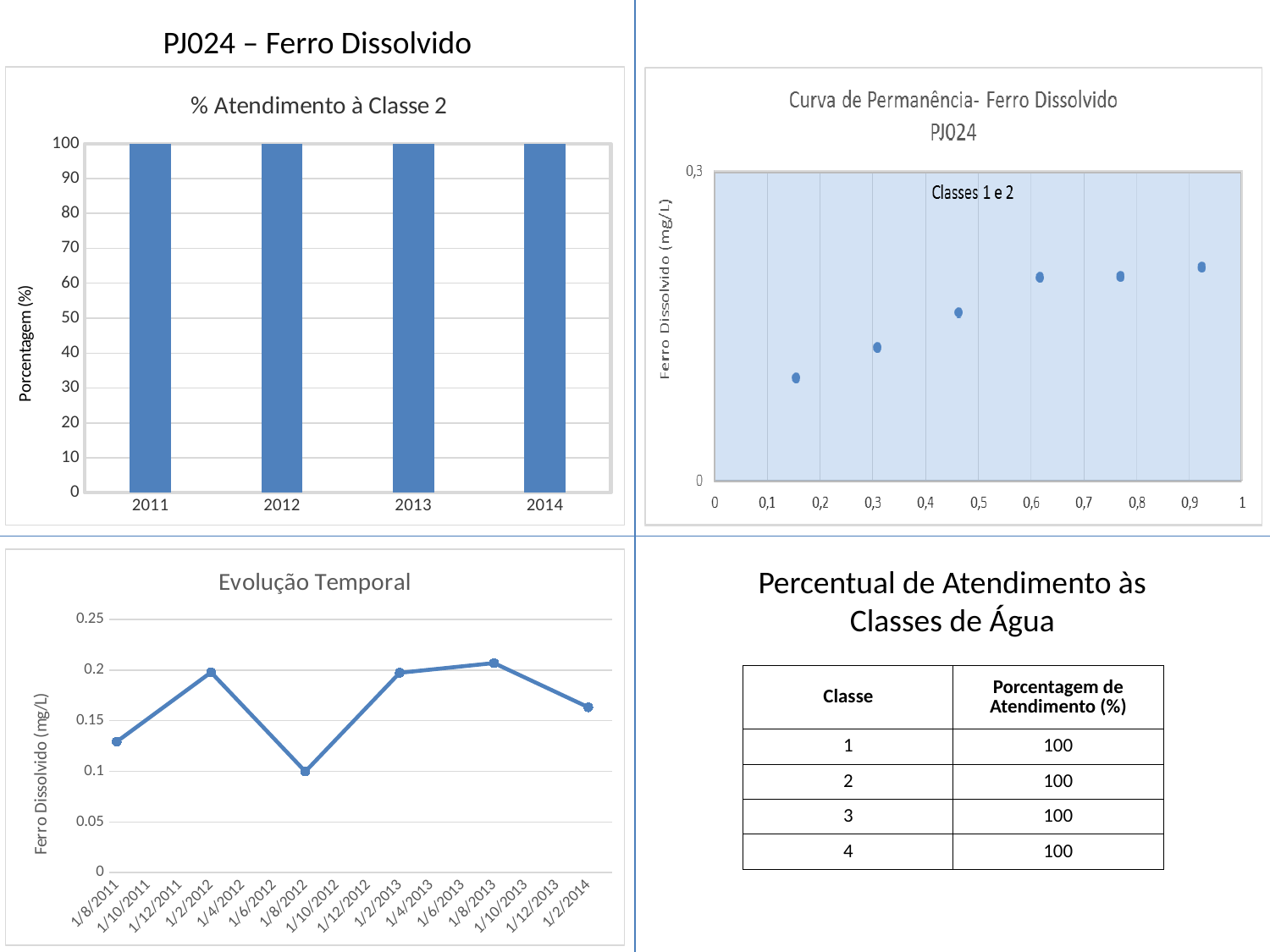
What is the y-axis title of the '% Atendimento à Classe 2' chart? Porcentagem (%) What kind of chart is '% Atendimento à Classe 2'? bar chart In the 'Evolução Temporal' chart, which is larger, the value for 1/2/2012 or the value for 1/8/2012? 1/2/2012 How many years are shown in the '% Atendimento à Classe 2' chart? 4 In the 'Curva de Permanência- Ferro Dissolvido PJ024' chart, do the values rise or fall as the x axis increases? rise How many data points are plotted in the 'Curva de Permanência- Ferro Dissolvido PJ024' chart? 6 In the 'Evolução Temporal' chart, is the value for 1/8/2011 greater or less than 0.15? less In the 'Curva de Permanência- Ferro Dissolvido PJ024' chart, is the value of the point at x = 0.9 greater or less than 0.3? less In the '% Atendimento à Classe 2' chart, what is the value for 2011? 100 What kind of chart is 'Evolução Temporal'? line chart In the '% Atendimento à Classe 2' chart, what is the value for 2014? 100 In the 'Evolução Temporal' chart, which date has the lowest value? 1/8/2012